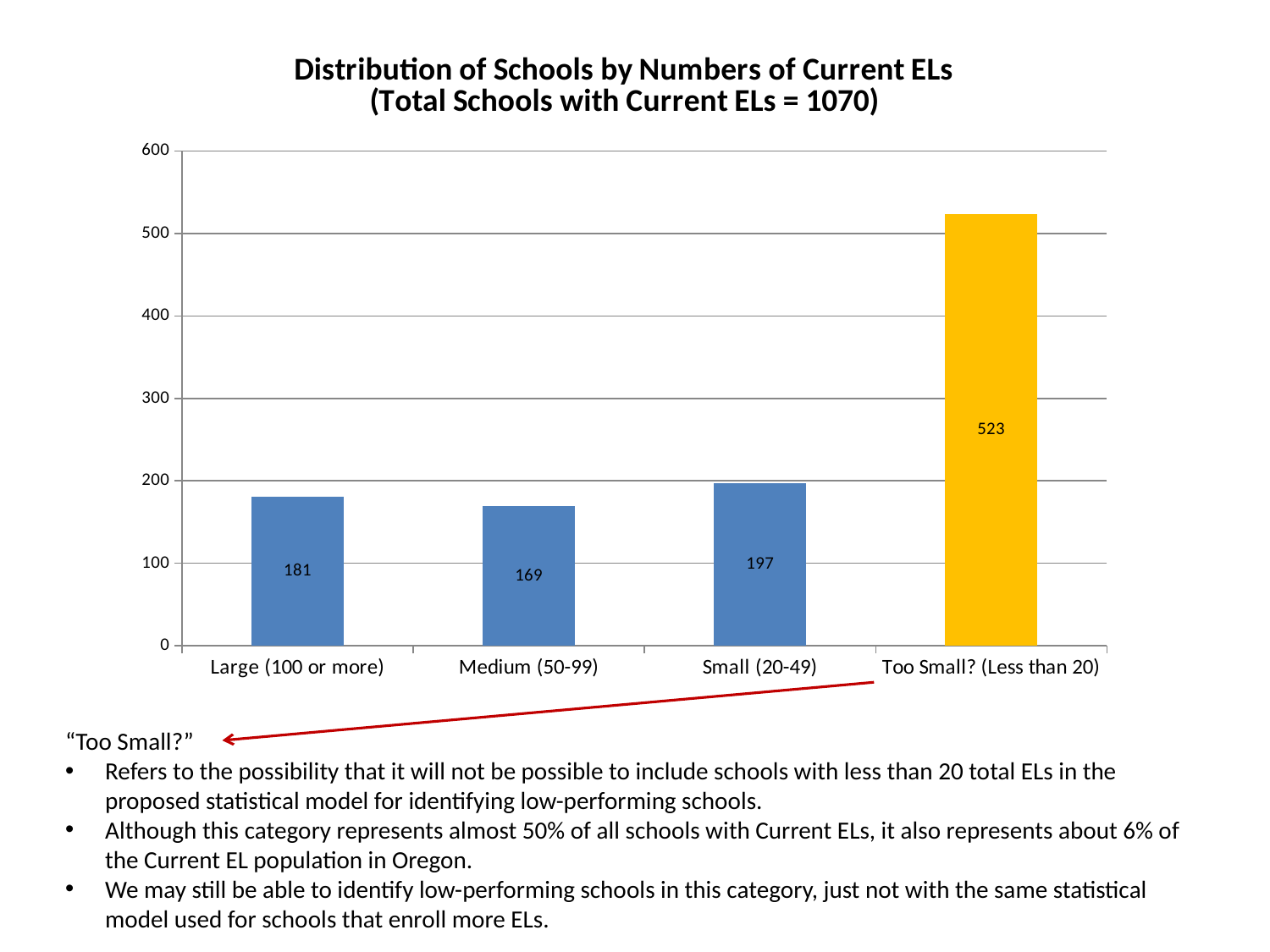
Which is larger, the value for Small (20-49) or the value for Large (100 or more)? Small (20-49) What kind of chart is shown on the slide? Bar chart What is the value for Too Small? (Less than 20)? 523 What is the value for Large (100 or more)? 181 What is the difference between the values for Large (100 or more) and Medium (50-99)? 12 How many categories are shown on the x axis? 4 What is the value for Medium (50-99)? 169 Which category has the highest value? Too Small? (Less than 20) What is the value for Small (20-49)? 197 What is the difference between the values for Too Small? (Less than 20) and Small (20-49)? 326 Which bar is coloured differently from the others? Too Small? (Less than 20) Which category has the lowest value? Medium (50-99)